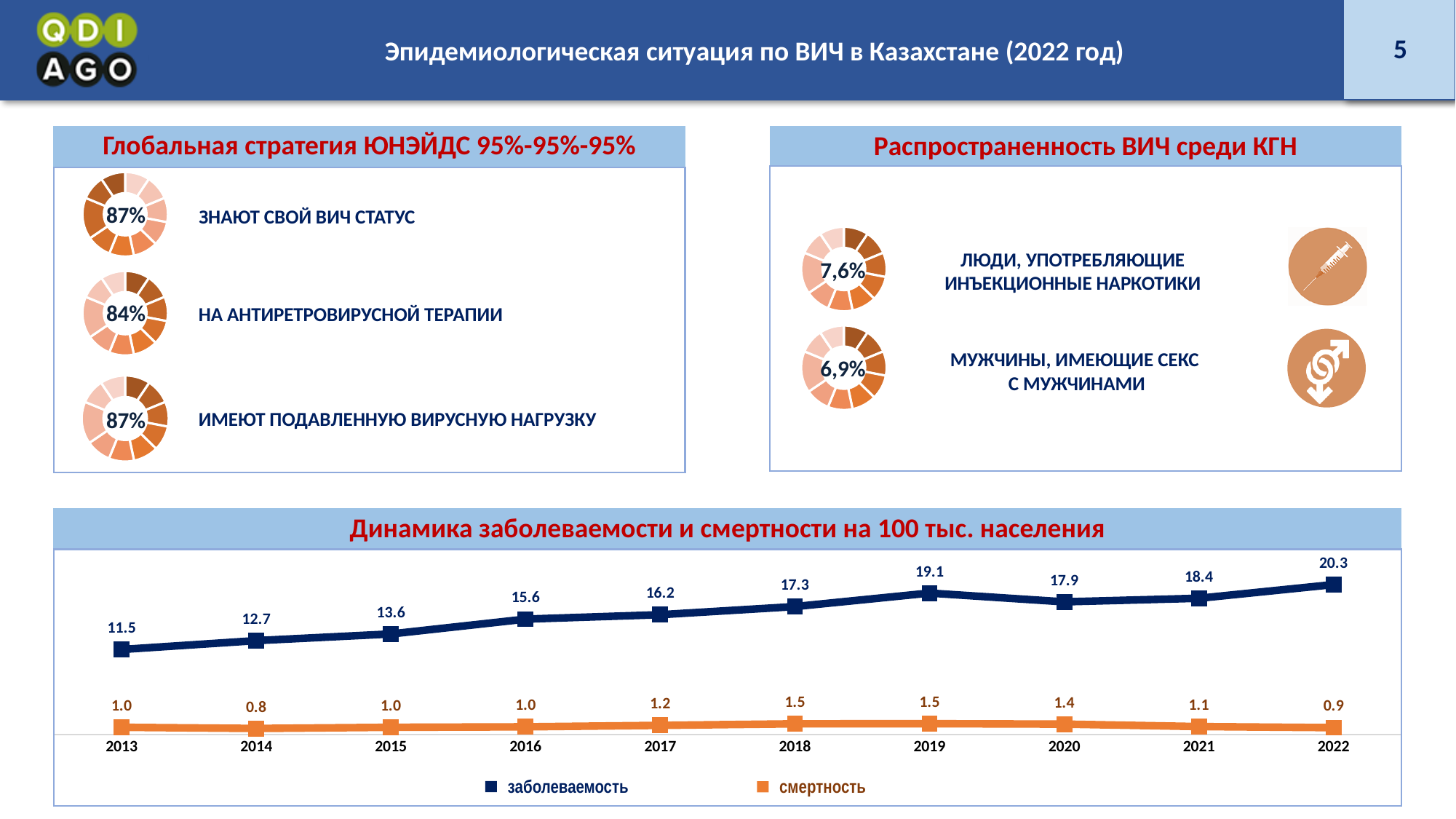
In the chart 'Динамика заболеваемости и смертности на 100 тыс. населения', which year has the lowest value of смертность? 2014 How many years are shown on the x axis of the chart 'Динамика заболеваемости и смертности на 100 тыс. населения'? 10 What kind of chart is 'Динамика заболеваемости и смертности на 100 тыс. населения'? line chart In the chart 'Динамика заболеваемости и смертности на 100 тыс. населения', what is the value of смертность in 2018? 1.5 In the chart 'Динамика заболеваемости и смертности на 100 тыс. населения', which is larger: заболеваемость in 2019 or in 2020? 2019 In the chart 'Динамика заболеваемости и смертности на 100 тыс. населения', what is the difference between заболеваемость in 2022 and in 2013? 8.8 In the panel 'Распространенность ВИЧ среди КГН', what percentage is shown for 'Люди, употребляющие инъекционные наркотики'? 7,6% In the chart 'Динамика заболеваемости и смертности на 100 тыс. населения', which year has the highest value of заболеваемость? 2022 In the panel 'Глобальная стратегия ЮНЭЙДС 95%-95%-95%', what percentage is shown for 'На антиретровирусной терапии'? 84% In the chart 'Динамика заболеваемости и смертности на 100 тыс. населения', does заболеваемость generally rise or fall from 2013 to 2022? rise How many series does the legend of the chart 'Динамика заболеваемости и смертности на 100 тыс. населения' list? 2 In the chart 'Динамика заболеваемости и смертности на 100 тыс. населения', what is the value of заболеваемость in 2022? 20.3